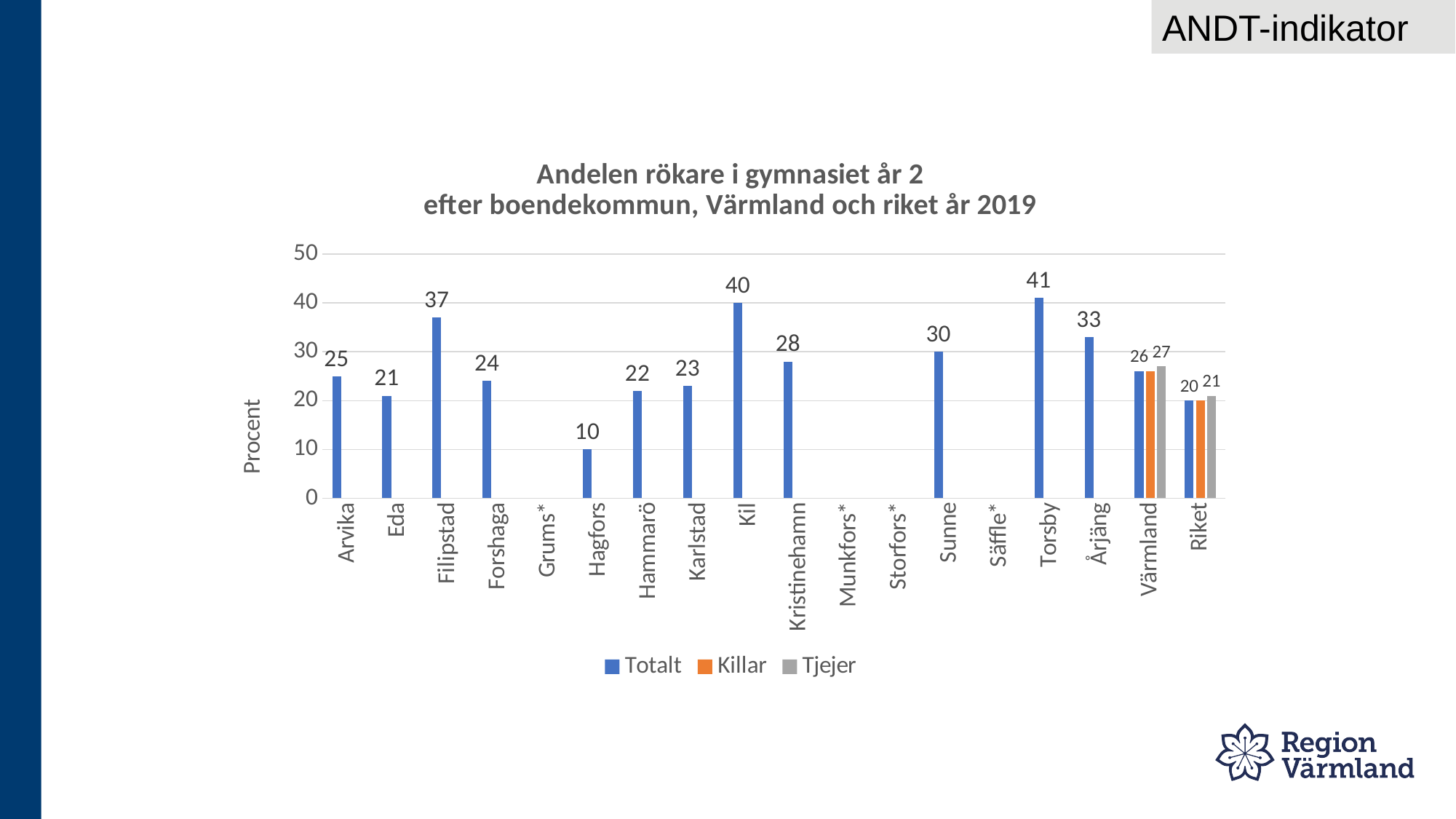
How many series does the legend list? 3 What is the Tjejer value for Värmland? 27 What kind of chart is shown on the slide? Bar chart What is the Tjejer value for Riket? 21 Which is larger, the value for Sunne or the value for Kristinehamn? Sunne What is the value for Kil? 40 Which municipality has the lowest share of smokers? Hagfors Which colour represents the Killar series in the legend? Orange What is the value for Hagfors? 10 How many categories are shown on the x axis? 18 Which municipality has the highest share of smokers? Torsby What is the difference between the values for Filipstad and Eda? 16